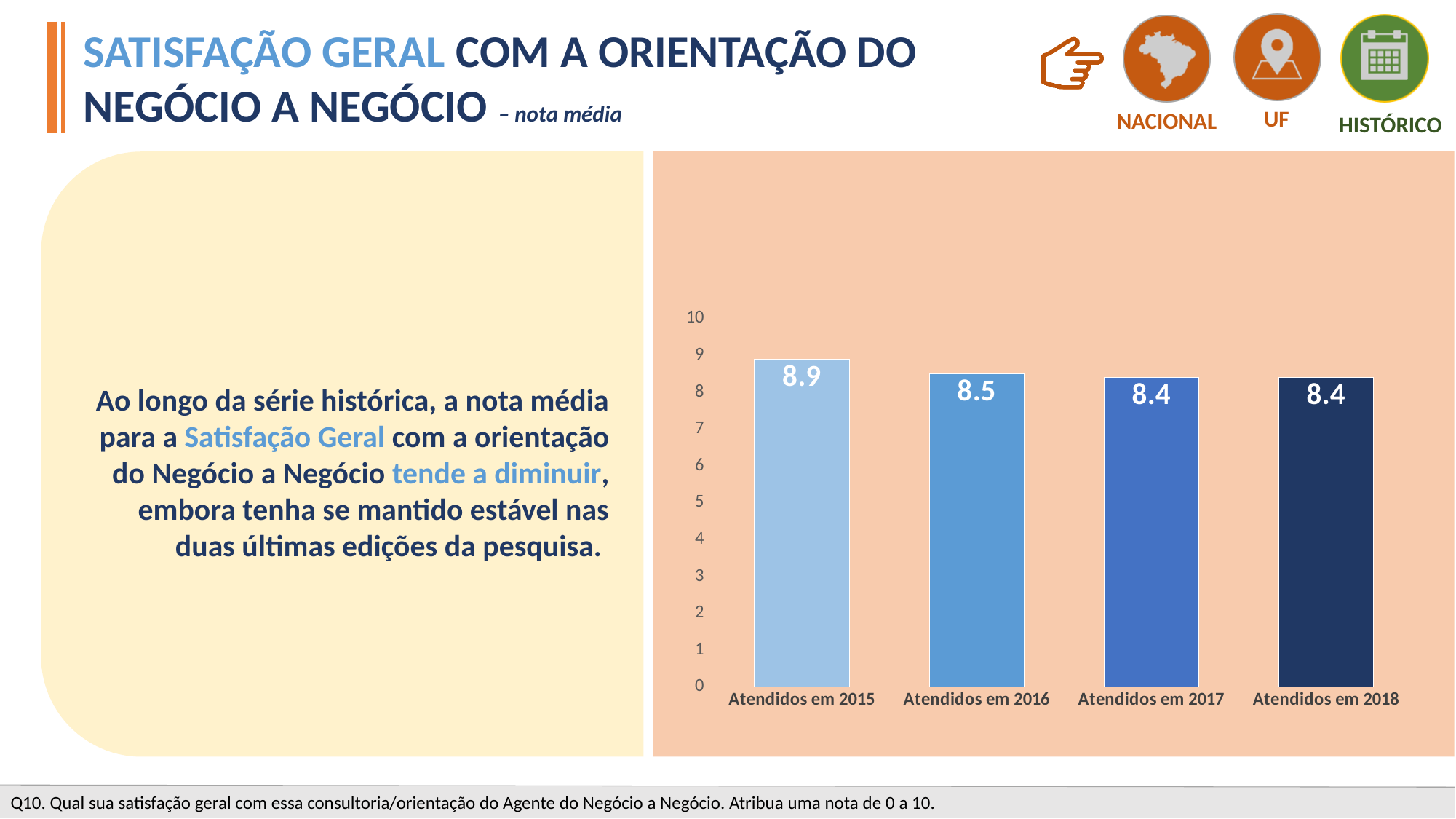
What is the value for Atendidos em 2017? 8.4 What is the value for Atendidos em 2016? 8.5 What kind of chart is shown on the slide? bar chart How many categories are shown on the x axis? 4 Is the value for Atendidos em 2016 greater or less than 8? greater What is the value for Atendidos em 2018? 8.4 What is the difference between the values for Atendidos em 2015 and Atendidos em 2018? 0.5 Do the values rise or fall from Atendidos em 2015 to Atendidos em 2018? fall What is the difference between the values for Atendidos em 2015 and Atendidos em 2016? 0.4 Which category has the highest value? Atendidos em 2015 Which is larger, the value for Atendidos em 2015 or Atendidos em 2017? Atendidos em 2015 What is the value for Atendidos em 2015? 8.9